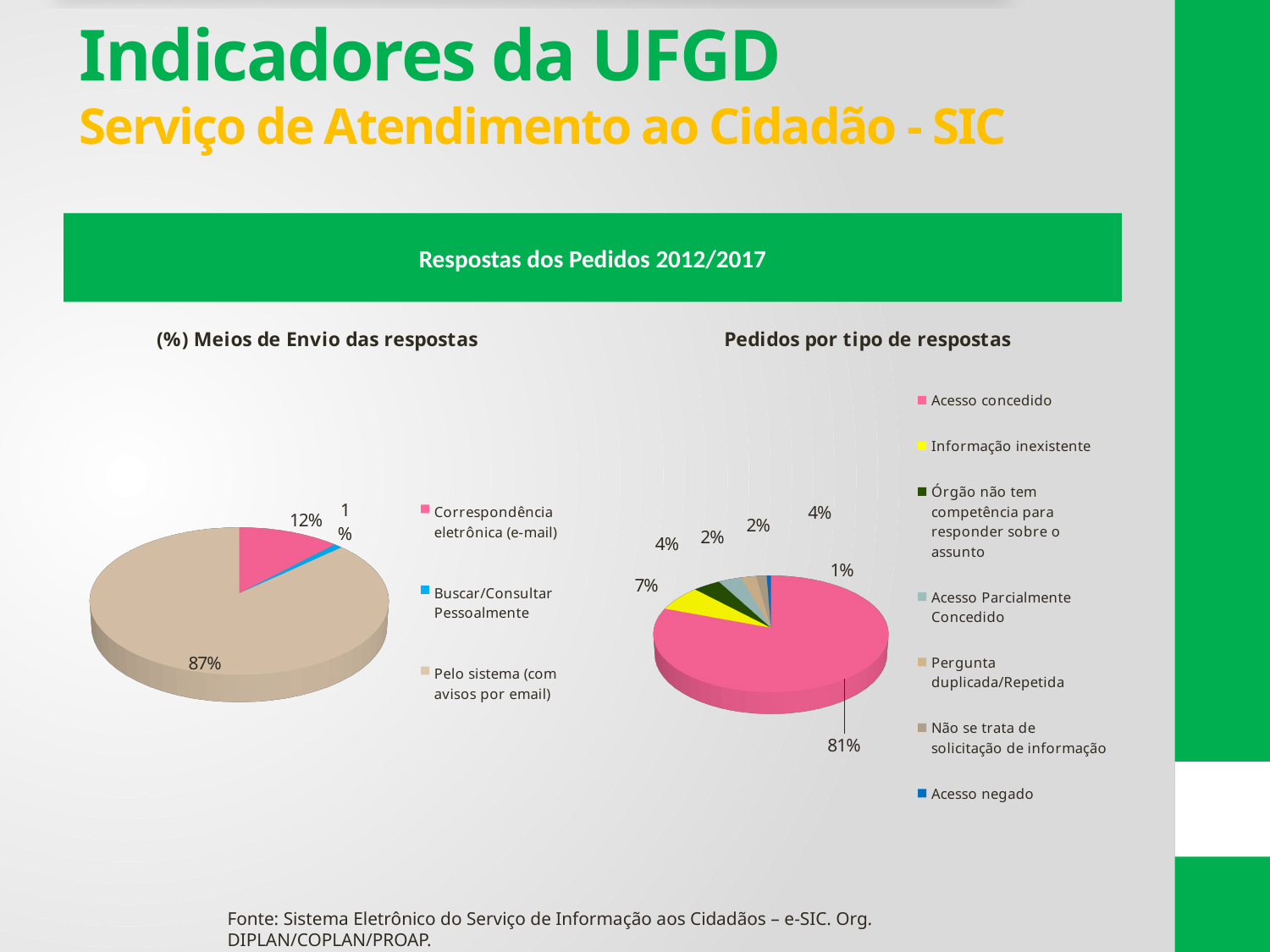
In the '(%) Meios de Envio das respostas' chart, how many categories does the legend list? 3 In the '(%) Meios de Envio das respostas' chart, what share is 'Pelo sistema (com avisos por email)'? 87% In the 'Pedidos por tipo de respostas' chart, how many categories does the legend list? 7 In the '(%) Meios de Envio das respostas' chart, what is the difference between the 'Pelo sistema' share and the 'Correspondência eletrônica' share? 75% What is the title of the green banner above the two charts? Respostas dos Pedidos 2012/2017 What type of chart is the '(%) Meios de Envio das respostas' chart? pie chart In the '(%) Meios de Envio das respostas' chart, what share is 'Buscar/Consultar Pessoalmente'? 1% In the '(%) Meios de Envio das respostas' chart, which category has the largest share? Pelo sistema (com avisos por email) In the 'Pedidos por tipo de respostas' chart, what share is 'Informação inexistente'? 7% In the 'Pedidos por tipo de respostas' chart, which category has the smallest share? Acesso negado